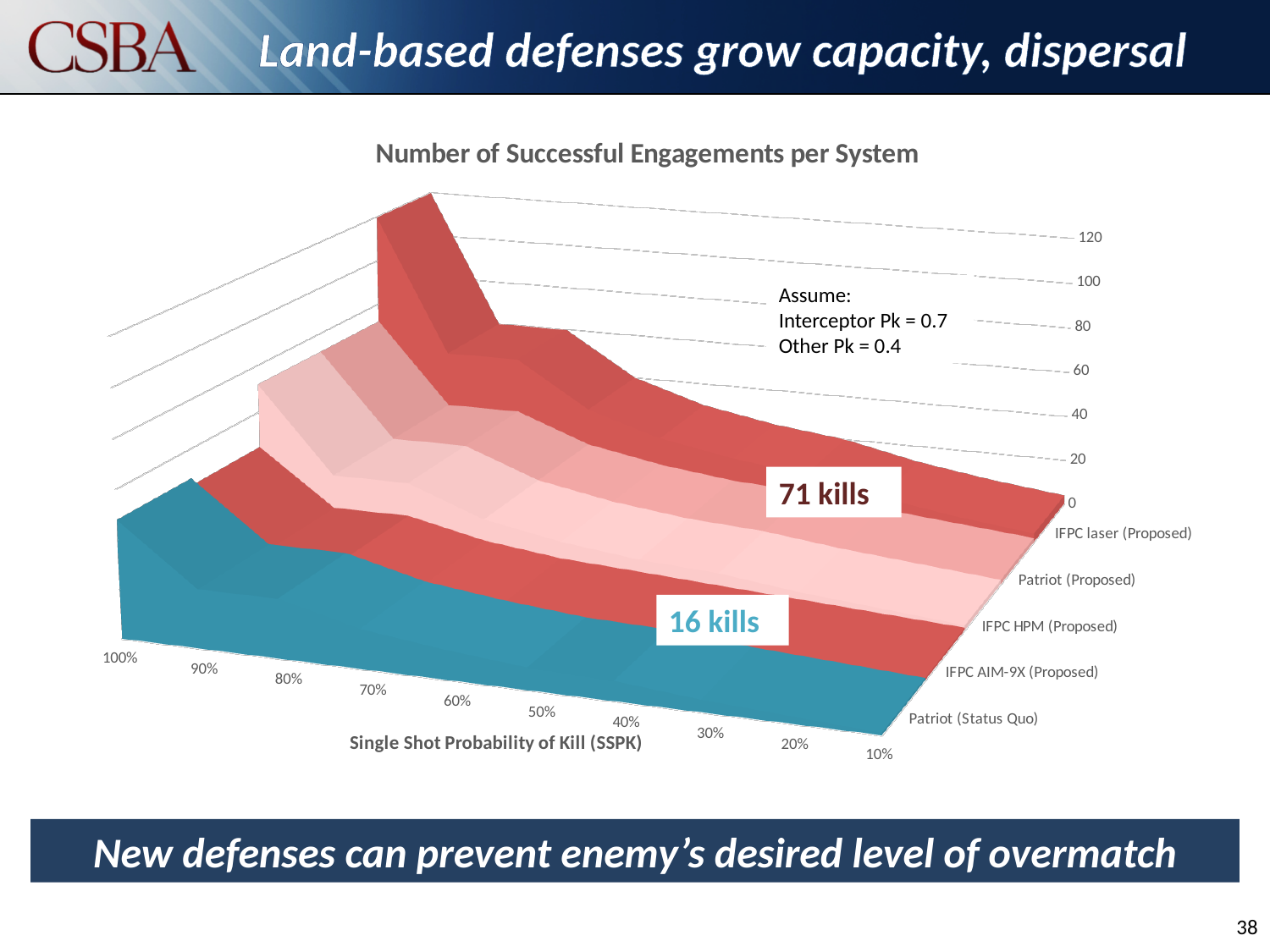
What is the label of the x axis? Single Shot Probability of Kill (SSPK) What two kill counts are annotated on the chart? 71 kills and 16 kills Is the peak value for IFPC laser (Proposed) greater or less than 60? greater What kill count is annotated on the Patriot (Status Quo) surface? 16 kills How many SSPK categories are shown along the x axis? 10 How many defense systems (series) are plotted on the chart? 5 Do the number of successful engagements rise or fall as SSPK increases from 10% to 100%? rise What is the maximum value shown on the vertical axis? 120 Which system reaches the highest number of successful engagements on the chart? IFPC laser (Proposed) What is the title of the chart? Number of Successful Engagements per System What kind of chart is shown on the slide? 3D area chart